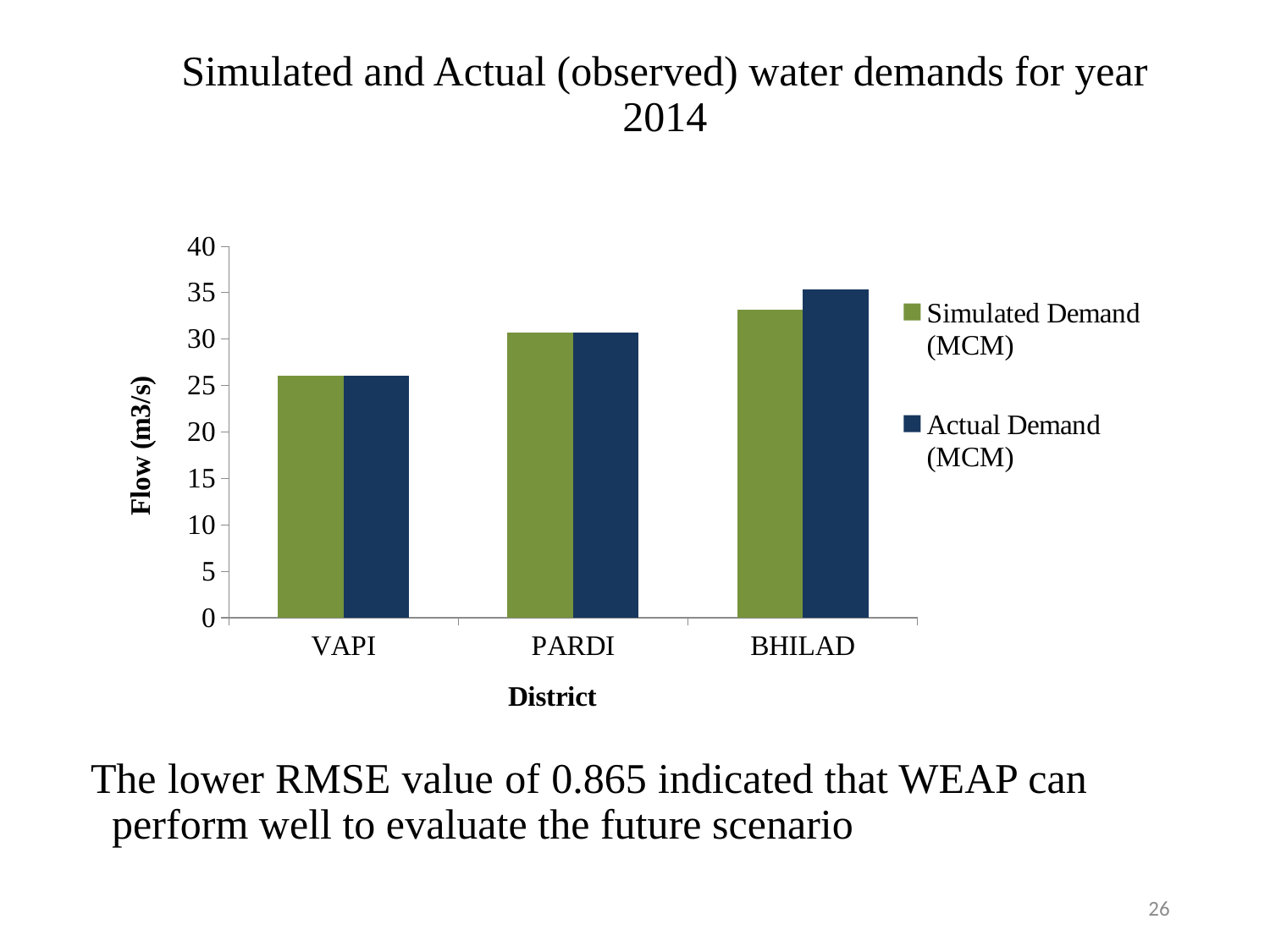
Do the Actual Demand (MCM) values rise or fall from VAPI to BHILAD along the x axis? rise What is the label of the chart's y axis? Flow (m3/s) Is the Simulated Demand (MCM) for BHILAD greater or less than 35? less How many districts are shown on the x axis of the chart? 3 Which district has the highest Actual Demand (MCM)? BHILAD For BHILAD, which is larger: Simulated Demand (MCM) or Actual Demand (MCM)? Actual Demand (MCM) Is the Actual Demand (MCM) for PARDI greater or less than 25? greater How many series does the chart's legend list? 2 What kind of chart is shown on the slide? bar chart Which district has a larger Simulated Demand (MCM): VAPI or PARDI? PARDI Which district has the lowest Simulated Demand (MCM)? VAPI Is the Simulated Demand (MCM) for VAPI greater or less than 30? less